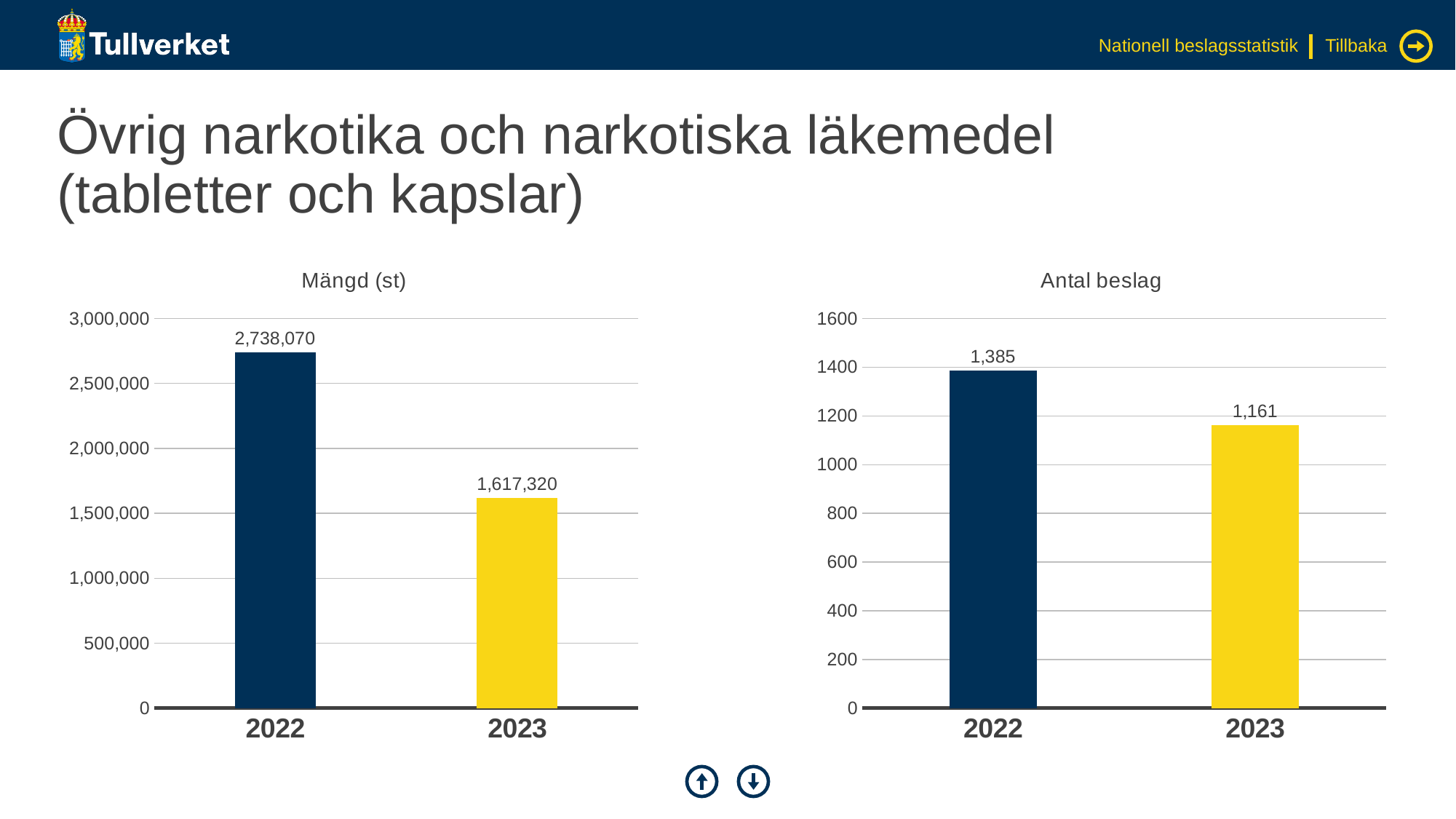
In the 'Mängd (st)' chart, which year has the highest value? 2022 In the 'Antal beslag' chart, is the value for 2022 greater or less than 1200? greater In the 'Mängd (st)' chart, what is the difference between the 2022 and 2023 values? 1,120,750 In the 'Mängd (st)' chart, what is the value for 2022? 2,738,070 What kind of chart is the 'Mängd (st)' chart? bar chart In the 'Mängd (st)' chart, what is the value for 2023? 1,617,320 How many bars are in the 'Antal beslag' chart? 2 In the 'Antal beslag' chart, which year has the lowest value? 2023 In the 'Mängd (st)' chart, do the values rise or fall from 2022 to 2023? fall In the 'Antal beslag' chart, what is the value for 2022? 1,385 In the 'Antal beslag' chart, what is the value for 2023? 1,161 In the 'Antal beslag' chart, what is the difference between the 2022 and 2023 values? 224